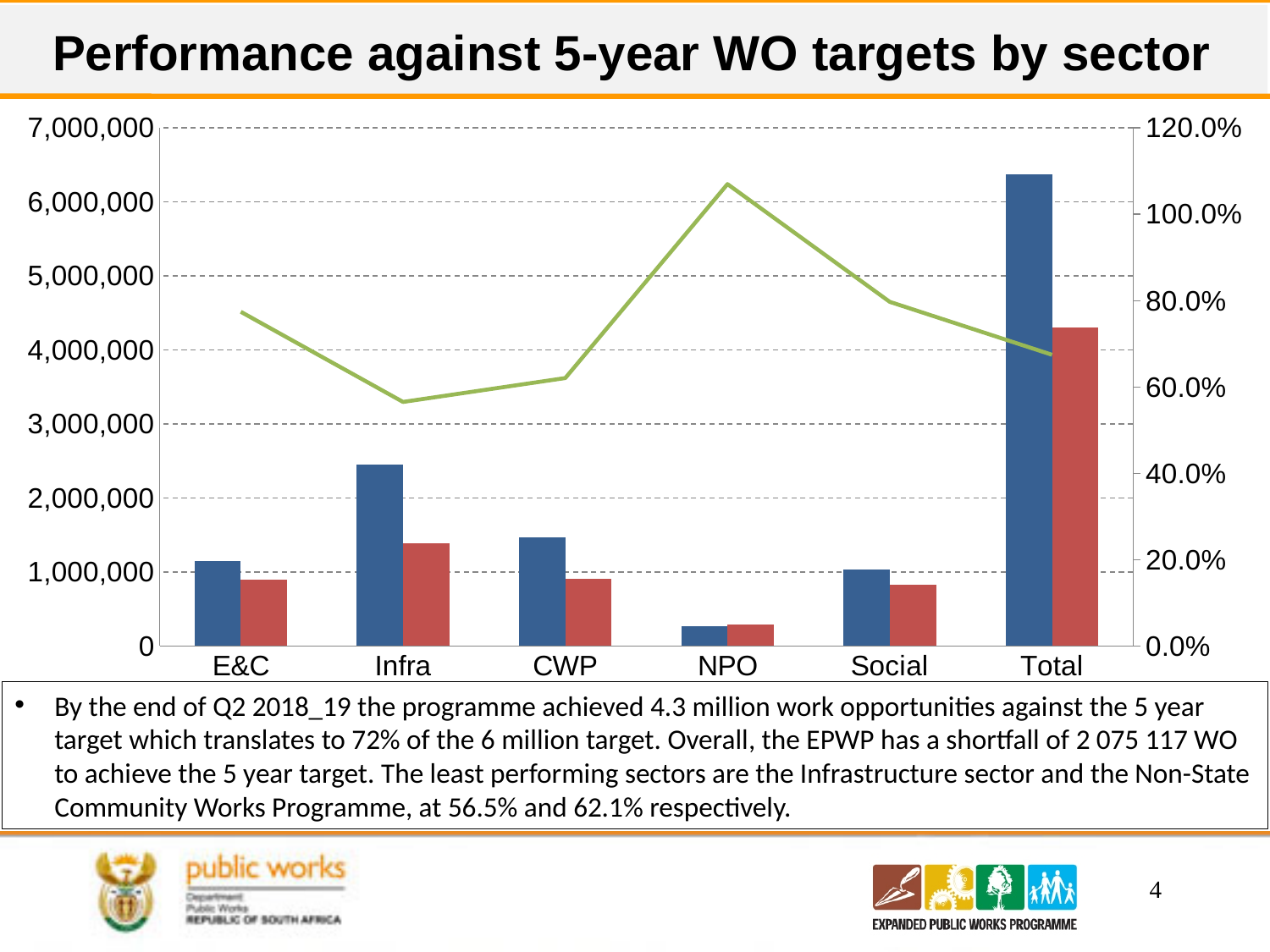
What is the title of the chart? Performance against 5-year WO targets by sector At which category does the green line reach its highest point? NPO What kind of chart is shown on the slide? Combination bar and line chart Which category has the tallest blue bar? Total How many sector categories are shown on the x axis of the chart? 6 Is the green line value for Infra greater or less than 60.0%? less Which category has the shortest blue bar? NPO Is the red bar for Total greater or less than 4,000,000? greater Is the green line value for NPO greater or less than 100.0%? greater At which category does the green line reach its lowest point? Infra Which has the taller blue bar, Infra or CWP? Infra